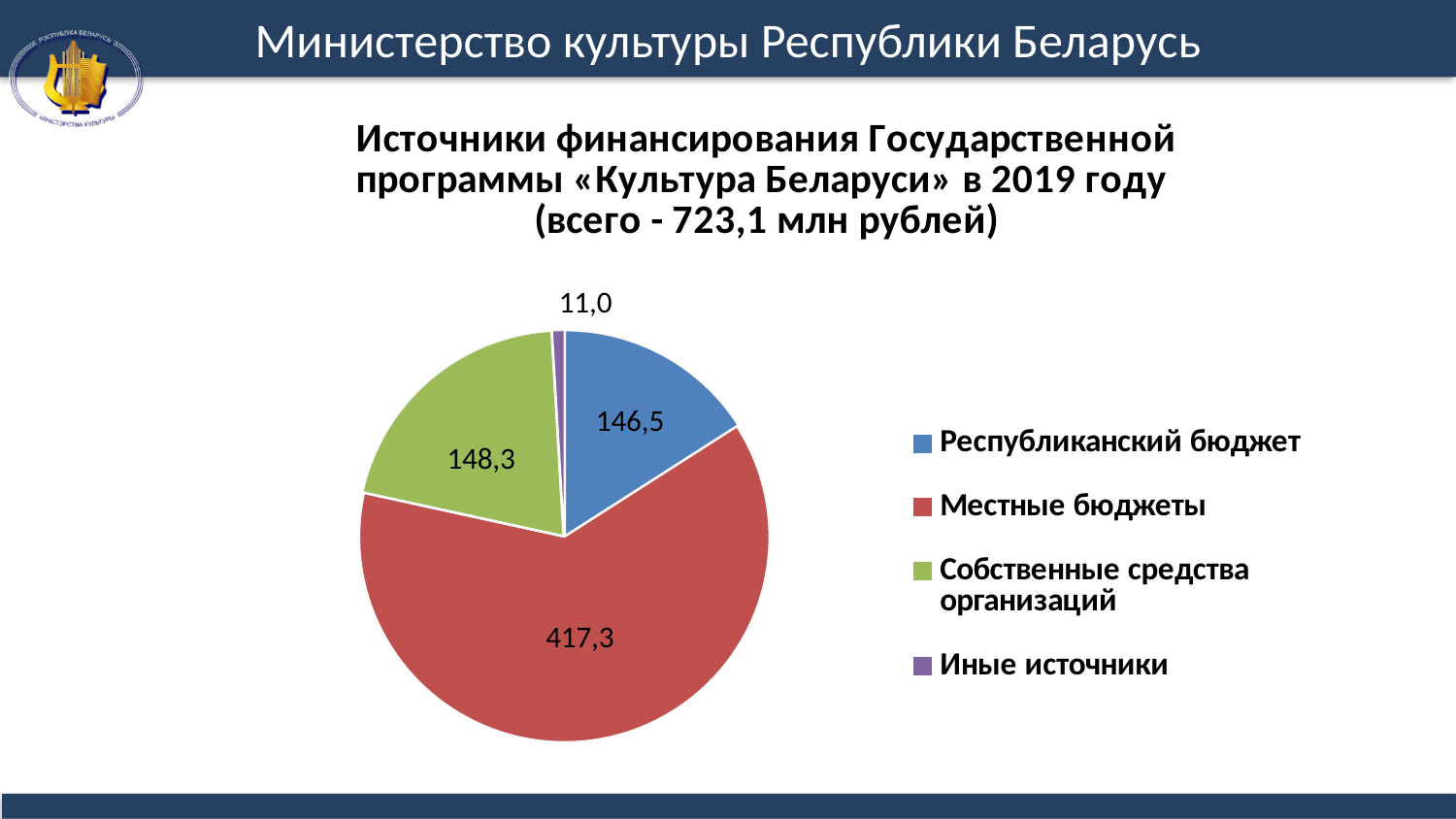
Which funding source has the largest slice of the pie? Местные бюджеты Which funding source has the smallest slice of the pie? Иные источники What value is shown for Иные источники? 11,0 What type of chart is shown on the slide? Pie chart What is the difference between the values for Собственные средства организаций and Республиканский бюджет? 1,8 What is the total of all four values shown in the pie chart? 723,1 How many slices does the pie chart have? 4 What is the difference between the values for Местные бюджеты and Республиканский бюджет? 270,8 Which is larger, the value for Республиканский бюджет or the value for Иные источники? Республиканский бюджет What value is shown for Местные бюджеты in the pie chart? 417,3 What value is shown for Собственные средства организаций? 148,3 What value is shown for Республиканский бюджет? 146,5